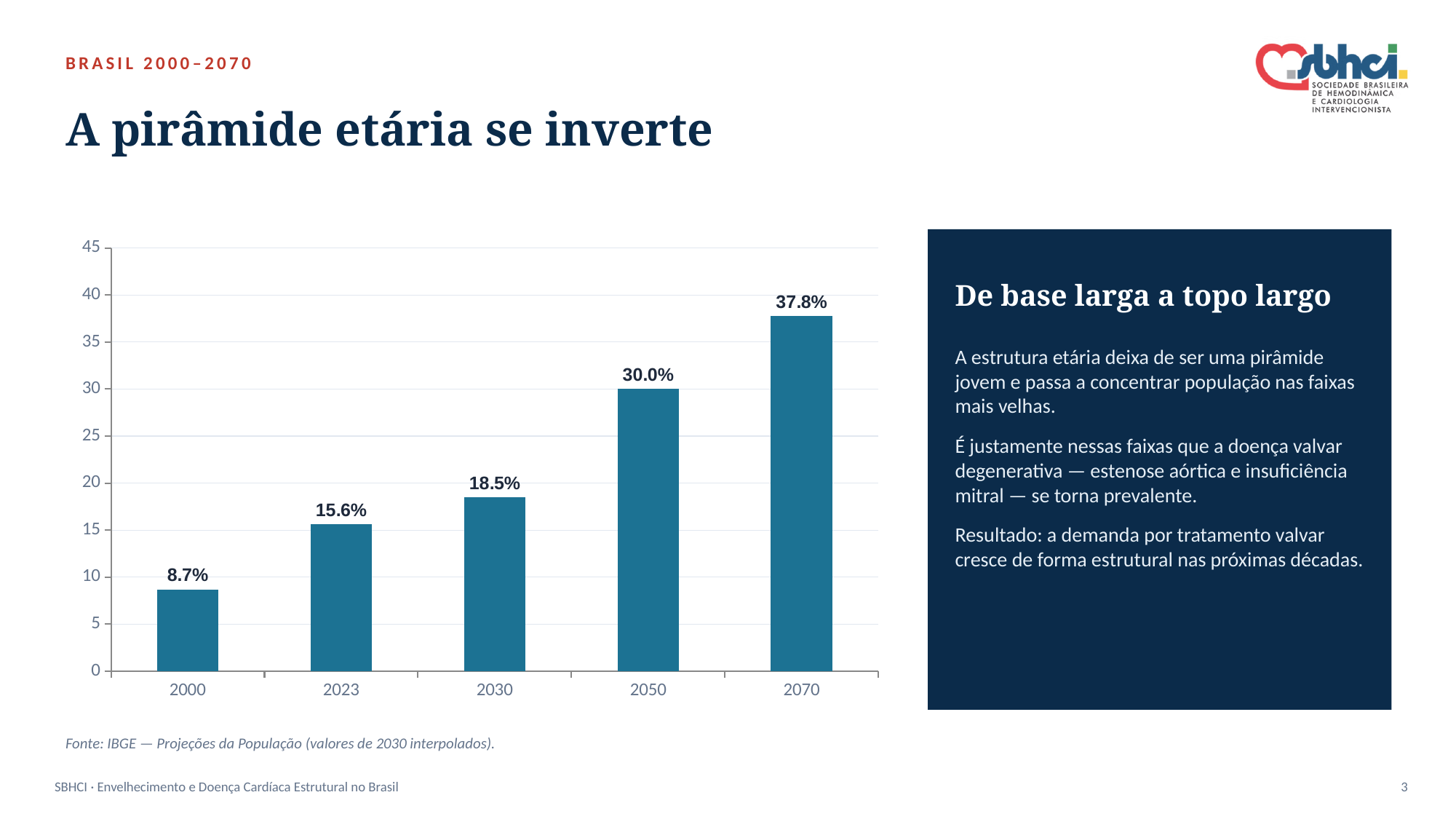
Which year has the lowest value? 2000 Which year has the highest value? 2070 Do the values rise or fall from 2000 to 2070? Rise What is the value for 2070? 37.8% What is the value for 2000? 8.7% What kind of chart is shown? Bar chart What is the difference between the values for 2070 and 2050? 7.8% Which is larger, the value for 2030 or the value for 2023? 2030 What is the value for 2023? 15.6% What is the difference between the values for 2030 and 2023? 2.9% What is the value for 2050? 30.0% How many years are shown on the x axis? 5